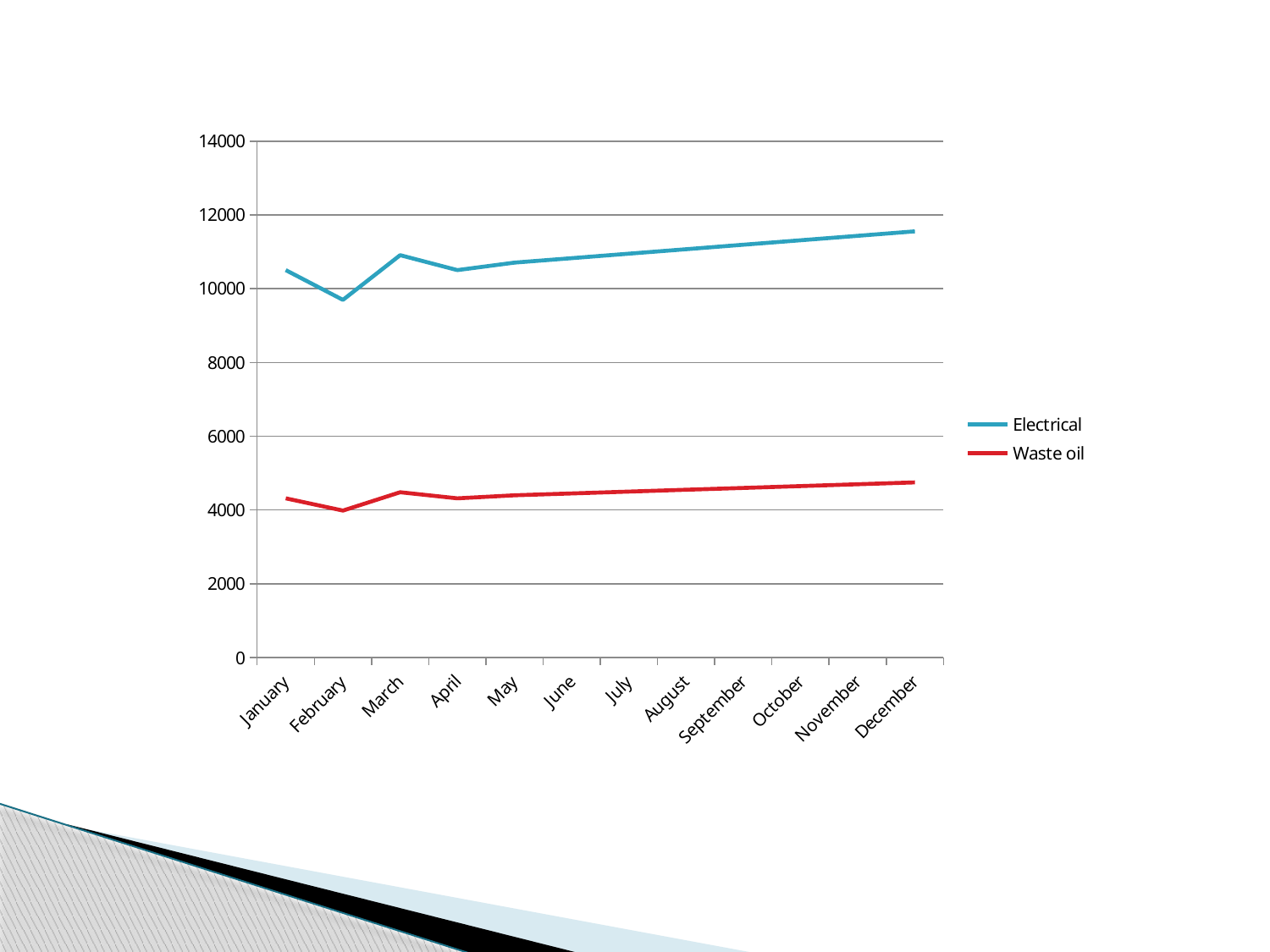
How many months are shown on the x axis? 12 What kind of chart is shown on the slide? Line chart In which month is the Waste oil series at its lowest? February In which month is the Electrical series at its lowest? February Is the value for Waste oil in December greater or less than 4000? greater Is the value for Electrical in February greater or less than 10000? less What colour is the line for the Waste oil series? Red In which month is the Electrical series at its highest? December Does the Electrical series rise or fall from April to December? Rise How many series does the legend list? 2 Which series has the larger value in June, Electrical or Waste oil? Electrical Is the value for Electrical in December greater or less than 10000? greater